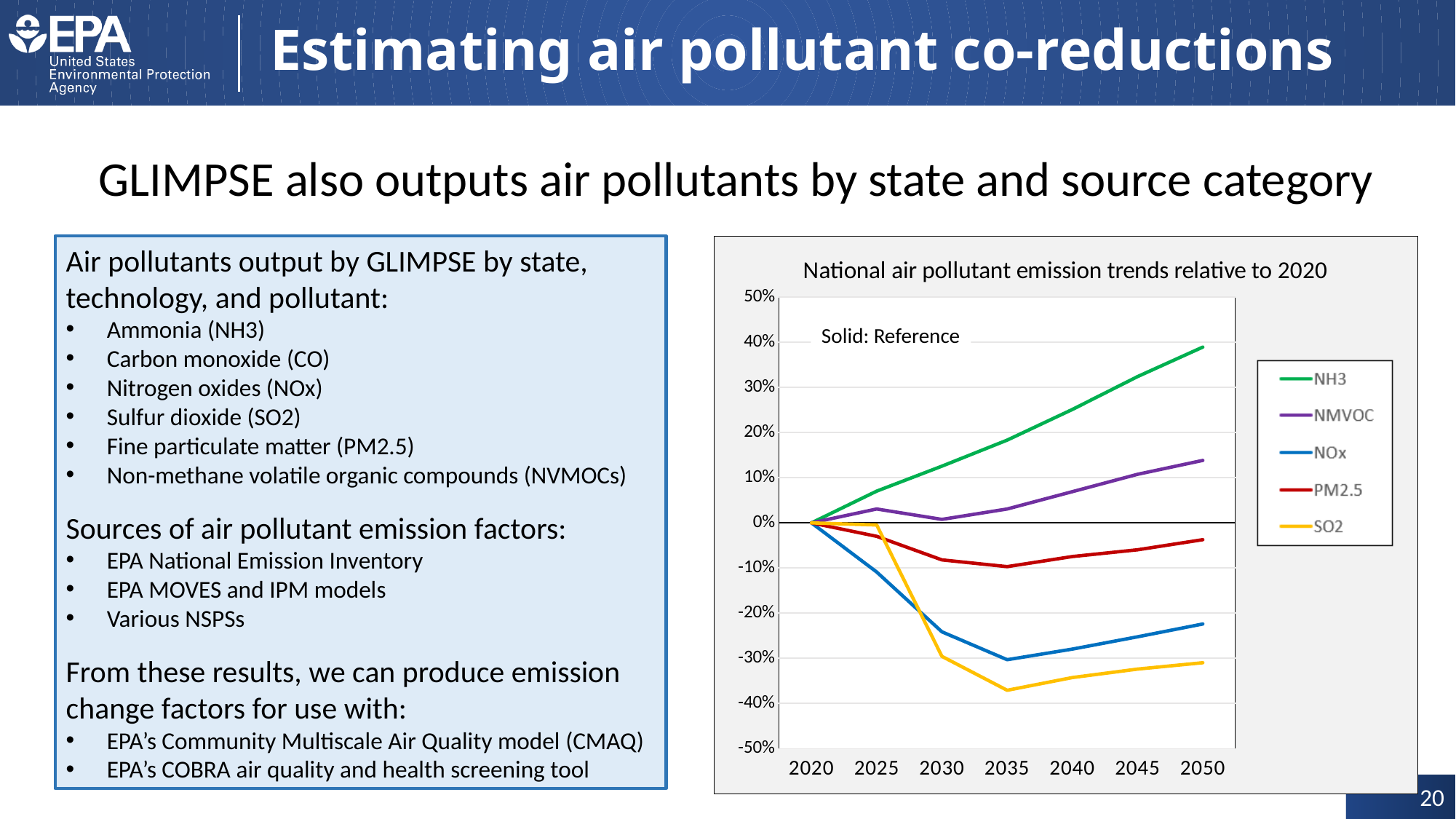
In 2025, which is larger, the value for NOx or the value for SO2? SO2 What is the title of the chart? National air pollutant emission trends relative to 2020 Is the value for NMVOC in 2050 greater or less than 10%? greater How many series does the chart legend list? 5 Is the value for SO2 in 2035 greater or less than -30%? less What kind of chart is shown on the slide? line chart Which series has the highest value in 2050? NH3 Is the value for NH3 in 2050 greater or less than 30%? greater How many years are labelled along the x axis of the chart? 7 Does the NH3 series rise or fall from 2020 to 2050? rise Which series has the lowest value in 2050? SO2 What is the value of the NH3 series in 2020? 0%